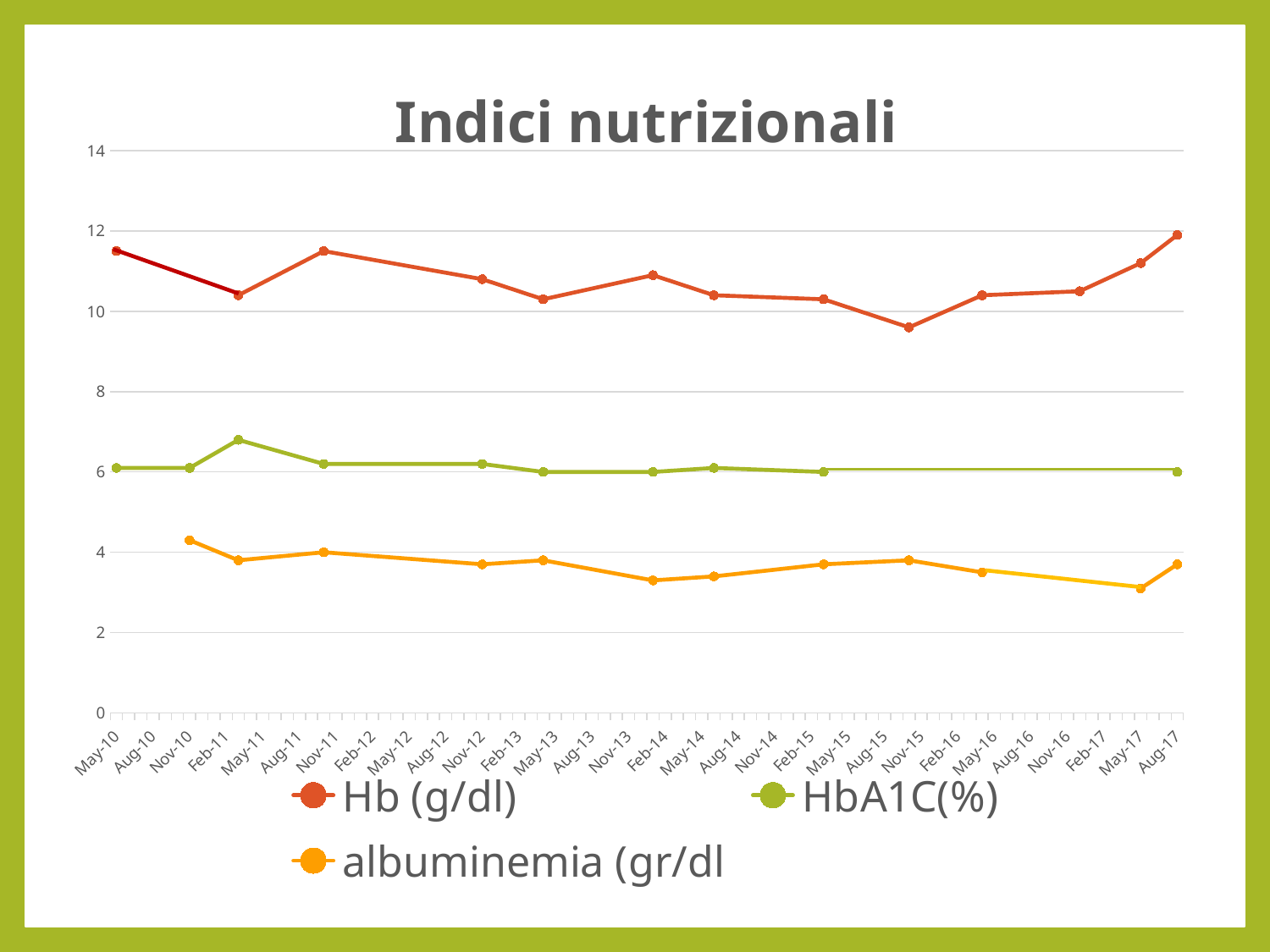
Which series is drawn in green? HbA1C(%) At which date is the HbA1C(%) series at its highest? Feb-11 What kind of chart is shown on the slide? line chart Is the value for albuminemia (gr/dl) at May-17 greater or less than 4? less Is the value for HbA1C(%) at Feb-11 greater or less than 6? greater Is the value for albuminemia (gr/dl) at Nov-10 greater or less than 4? greater Which is larger at Feb-11: the Hb (g/dl) value or the HbA1C(%) value? Hb (g/dl) What is the title of the chart? Indici nutrizionali Does the Hb (g/dl) series rise or fall from Nov-15 to Aug-17? rise At which date is the Hb (g/dl) series at its lowest? Nov-15 How many series does the legend list? 3